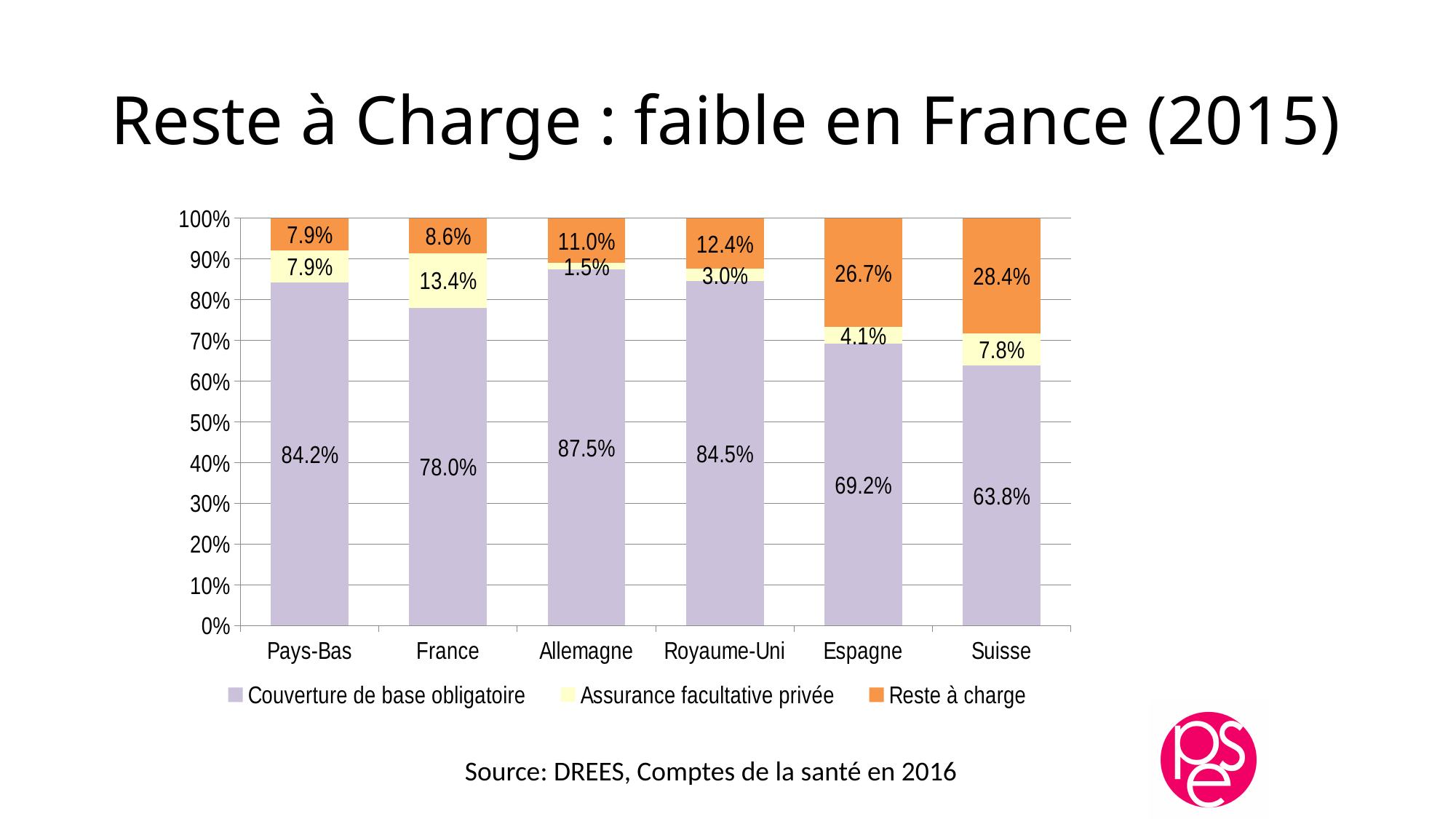
Which is larger, the Reste à charge for Royaume-Uni or for Allemagne? Royaume-Uni What is the value of Assurance facultative privée for Allemagne? 1.5% What is the value of Couverture de base obligatoire for France? 78.0% Which series is shown in orange? Reste à charge What is the difference in Reste à charge between Espagne and France? 18.1% How many series does the legend list? 3 Which country has the lowest Couverture de base obligatoire? Suisse What kind of chart is shown on the slide? Stacked bar chart Which country has the highest Reste à charge? Suisse Which country has the highest Assurance facultative privée? France How many countries are shown on the x axis? 6 What is the value of Reste à charge for Suisse? 28.4%